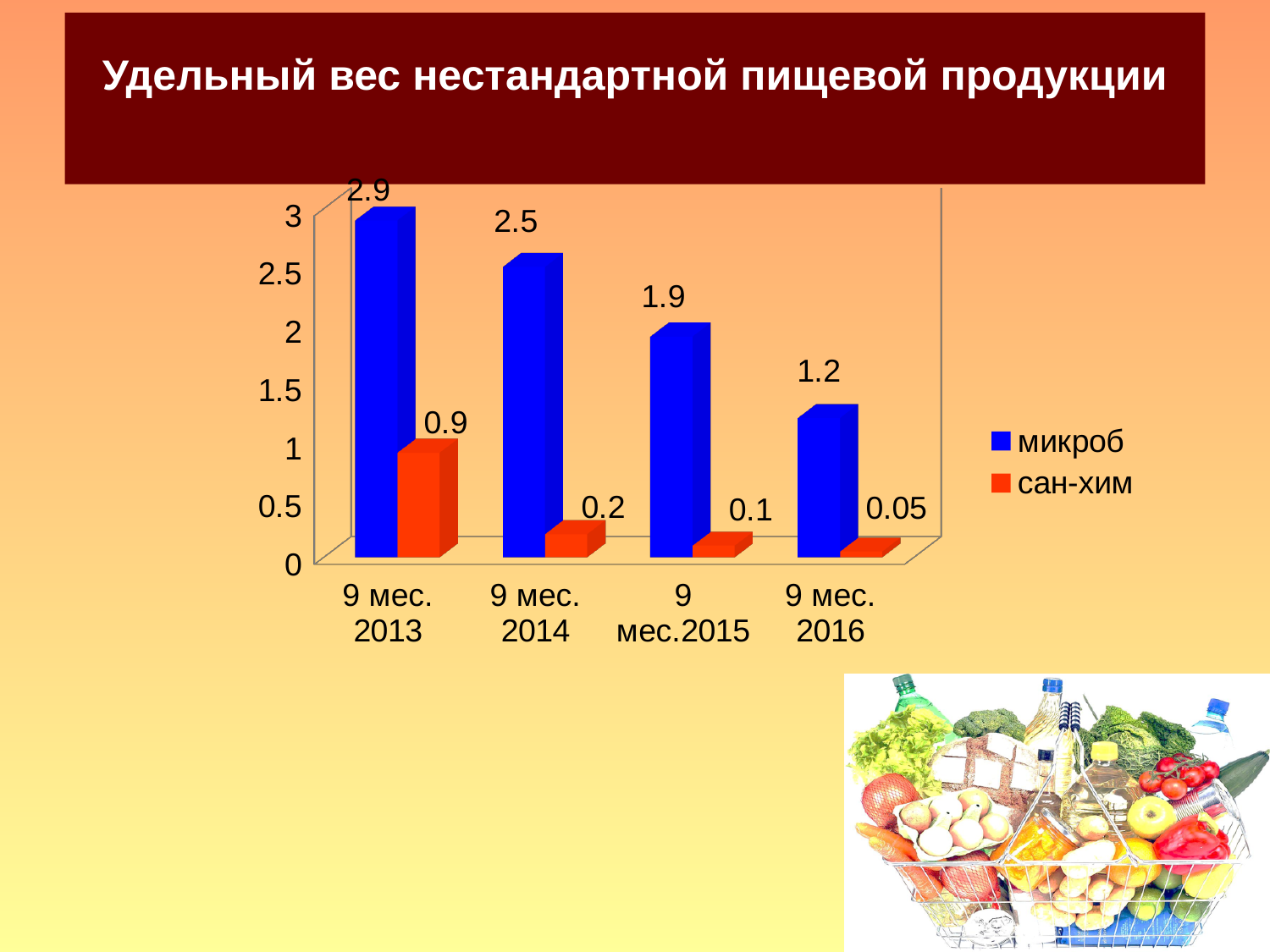
Which is larger: the сан-хим value for 9 мес. 2013 or for 9 мес.2015? 9 мес. 2013 Which period has the highest value for микроб? 9 мес. 2013 Do the микроб values rise or fall from 9 мес. 2013 to 9 мес. 2016? fall How many series does the legend list? 2 What is the difference between the микроб values for 9 мес. 2013 and 9 мес. 2016? 1.7 What kind of chart is shown on the slide? bar chart What is the value for микроб in 9 мес.2015? 1.9 How many periods are shown on the x axis? 4 What is the value for сан-хим in 9 мес. 2016? 0.05 What is the value for сан-хим in 9 мес. 2014? 0.2 Which period has the lowest value for сан-хим? 9 мес. 2016 What is the value for микроб in 9 мес. 2013? 2.9